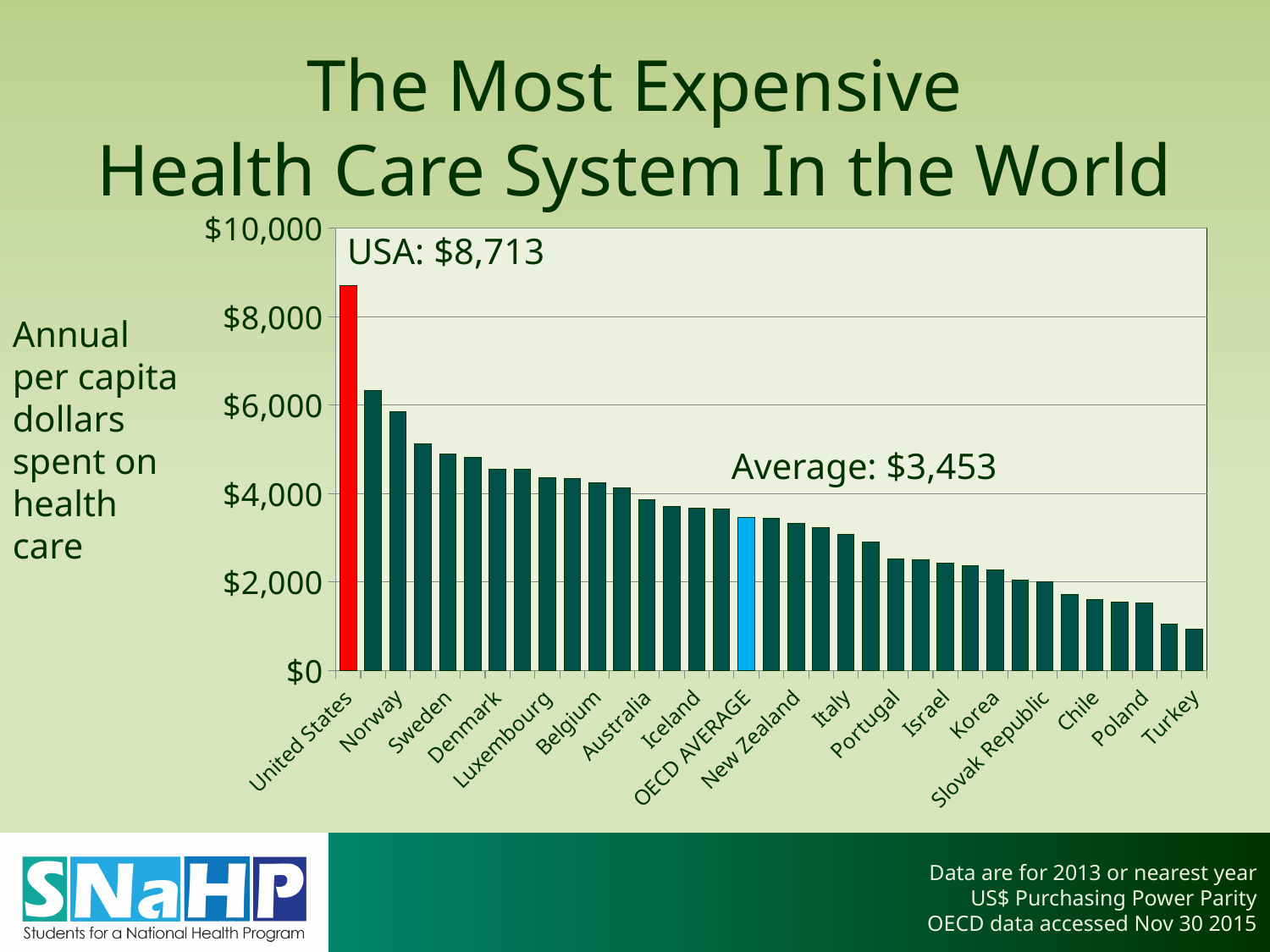
What value is shown for the OECD average? $3,453 Which country has the lowest per capita health care spending in the chart? Turkey What is the annual per capita health care spending shown for the United States? $8,713 Which country has the highest per capita health care spending in the chart? United States Is the value for Denmark greater or less than $4,000? greater Which spends more per capita on health care, Norway or Sweden? Norway Do the values rise or fall moving from left to right along the x axis? Fall What colour is the bar for the OECD AVERAGE? Blue Is the value for Turkey greater or less than $2,000? less How much more does the United States spend per capita than the OECD average? $5,260 What kind of chart is shown on the slide? Bar chart